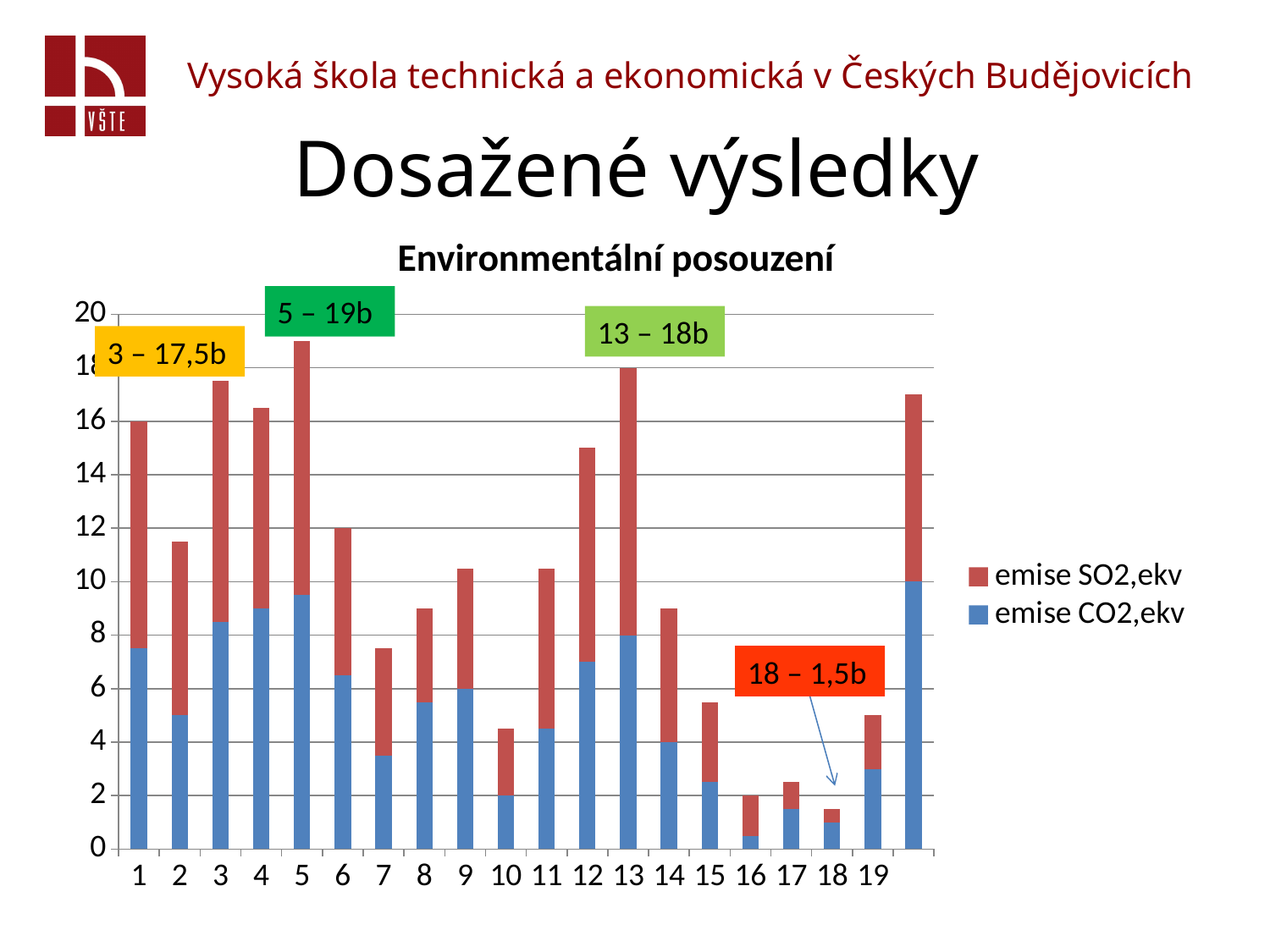
Which category has the highest total stacked bar? 5 According to the callout label, what is the total value of the stacked bar for category 5? 19b Which category has the lowest total stacked bar? 18 What are the two series named in the legend? emise SO2,ekv and emise CO2,ekv According to the callout label, what is the total value of the stacked bar for category 3? 17,5b How many series does the legend list? 2 Is the total value of the stacked bar for category 12 greater or less than 14? greater According to the callout label, what is the total value of the stacked bar for category 13? 18b What kind of chart is shown on the slide? bar chart What is the difference between the labelled totals for category 5 and category 18? 17,5b What is the title of the chart? Environmentální posouzení